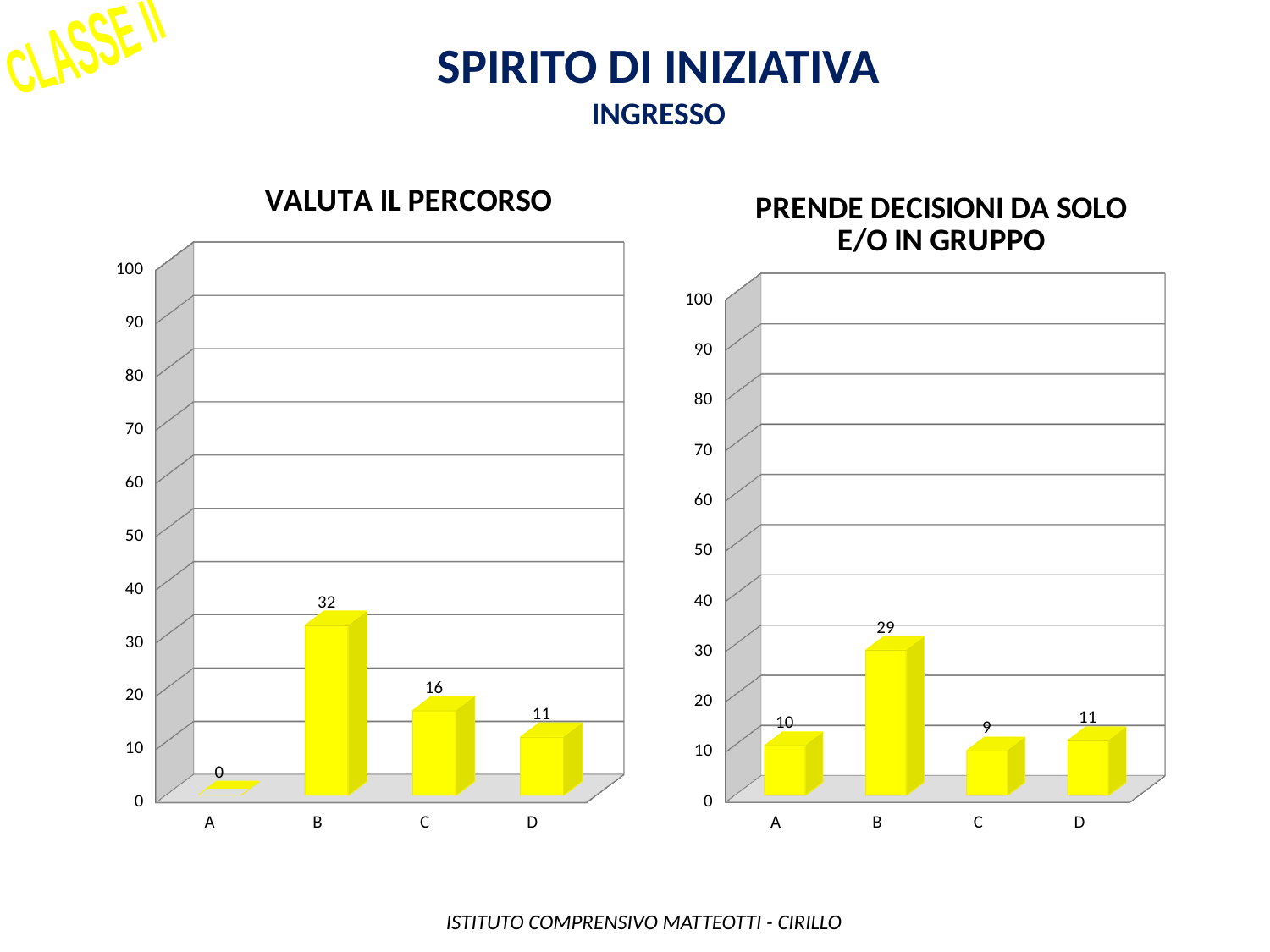
In the 'PRENDE DECISIONI DA SOLO E/O IN GRUPPO' chart, what is the value for category C? 9 In the 'PRENDE DECISIONI DA SOLO E/O IN GRUPPO' chart, what is the value for category B? 29 In the 'VALUTA IL PERCORSO' chart, what is the difference between the values for B and C? 16 In the 'VALUTA IL PERCORSO' chart, what is the value for category A? 0 In the 'VALUTA IL PERCORSO' chart, which category has the highest value? B In the 'PRENDE DECISIONI DA SOLO E/O IN GRUPPO' chart, what is the difference between the values for B and A? 19 How many categories are shown in the 'VALUTA IL PERCORSO' chart? 4 In the 'VALUTA IL PERCORSO' chart, what is the value for category B? 32 In the 'PRENDE DECISIONI DA SOLO E/O IN GRUPPO' chart, which is larger, the value for A or the value for D? D In the 'PRENDE DECISIONI DA SOLO E/O IN GRUPPO' chart, which category has the lowest value? C What kind of chart is the 'PRENDE DECISIONI DA SOLO E/O IN GRUPPO' chart? Bar chart In the 'VALUTA IL PERCORSO' chart, which category has the lowest value? A